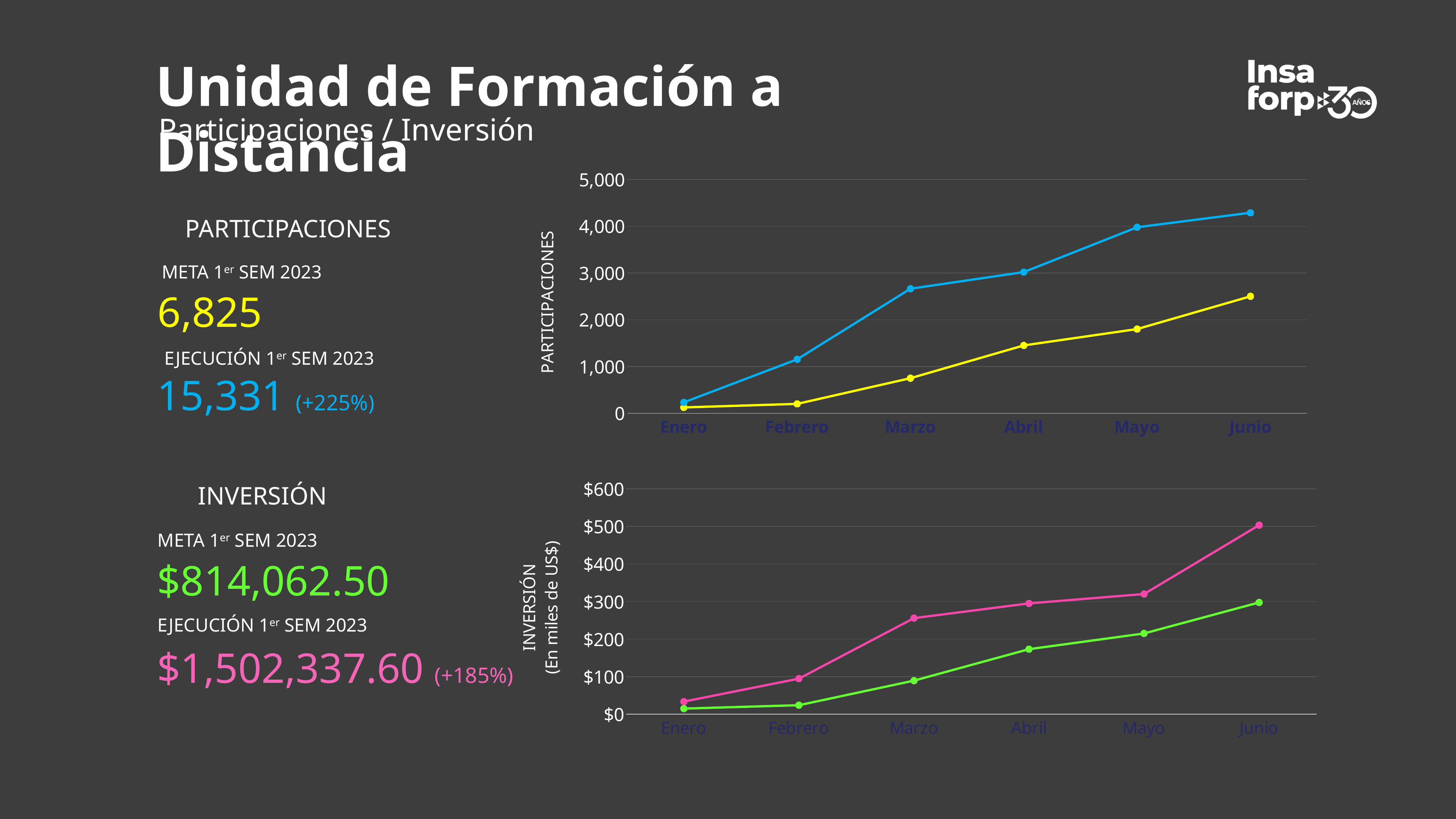
In the top chart, in which month does the blue line reach its highest value? Junio In the bottom chart, is the value of the pink line for Junio greater or less than $400? greater How many months are plotted along the x axis of the top chart? 6 In the top chart, in which month does the yellow line have its lowest value? Enero What kind of chart is the bottom chart on the slide? line chart In the top chart, does the blue line rise or fall from Enero to Junio? rise In the top chart, which line has the larger value for Junio, the blue line or the yellow line? blue line In the top chart, is the value of the yellow line for Abril greater or less than 2,000? less What kind of chart is the top chart on the slide? line chart In the top chart, is the value of the blue line for Marzo greater or less than 2,000? greater What is the y-axis label of the bottom chart? INVERSIÓN (En miles de US$)